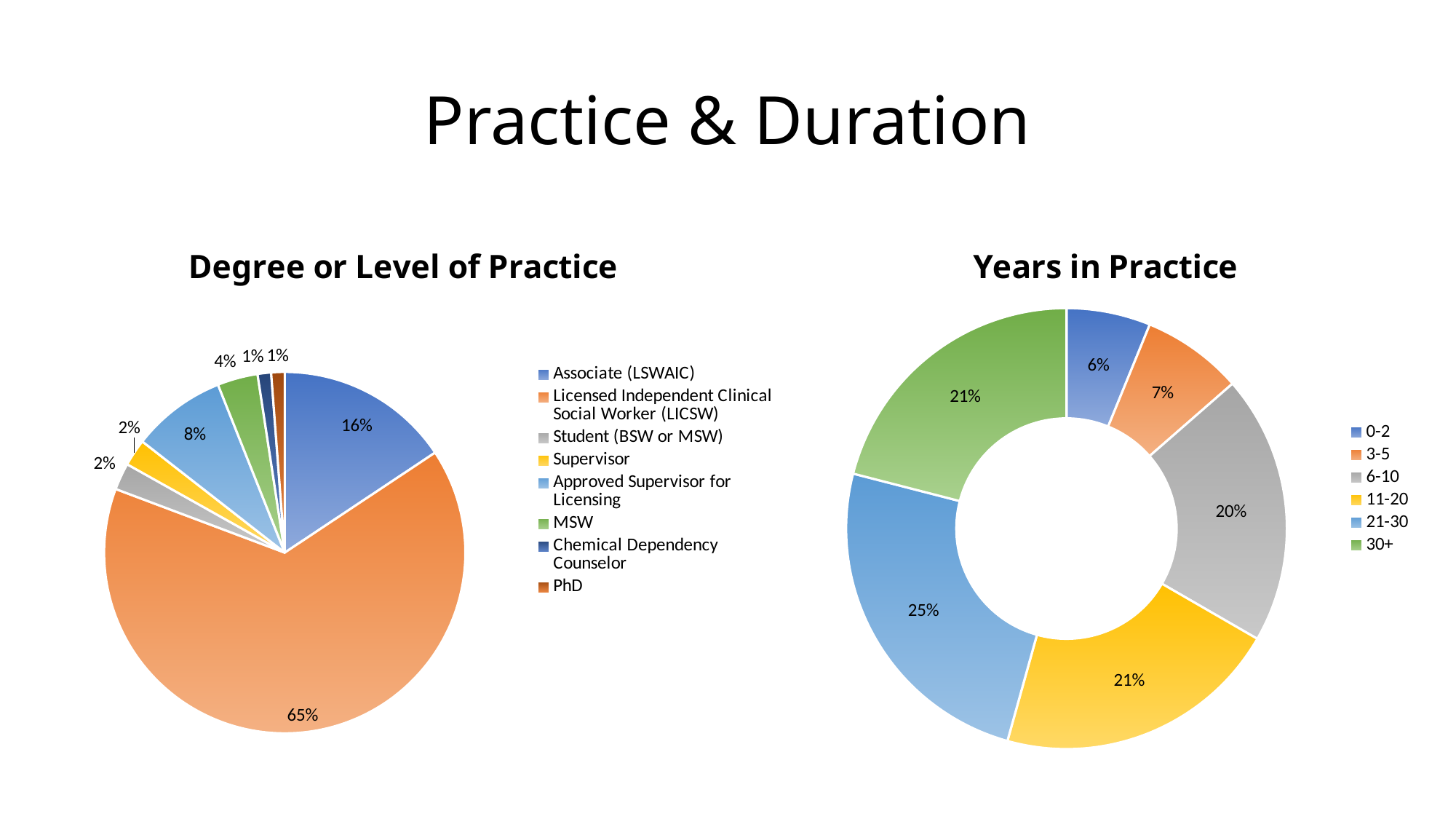
In the Years in Practice chart, how many categories are shown? 6 In the Years in Practice chart, what percentage is 0-2 years? 6% What kind of chart is the Years in Practice chart? Doughnut chart In the Degree or Level of Practice chart, what is the difference between the LICSW share and the Associate (LSWAIC) share? 49% In the Years in Practice chart, which category has the smallest share? 0-2 In the Degree or Level of Practice chart, which category has the largest share? Licensed Independent Clinical Social Worker (LICSW) In the Years in Practice chart, which is larger, 6-10 or 3-5? 6-10 In the Degree or Level of Practice chart, what percentage is Licensed Independent Clinical Social Worker (LICSW)? 65% In the Degree or Level of Practice chart, what percentage is Associate (LSWAIC)? 16% In the Degree or Level of Practice chart, what percentage is Approved Supervisor for Licensing? 8% In the Degree or Level of Practice chart, how many categories does the legend list? 8 In the Years in Practice chart, what percentage is 21-30 years? 25%